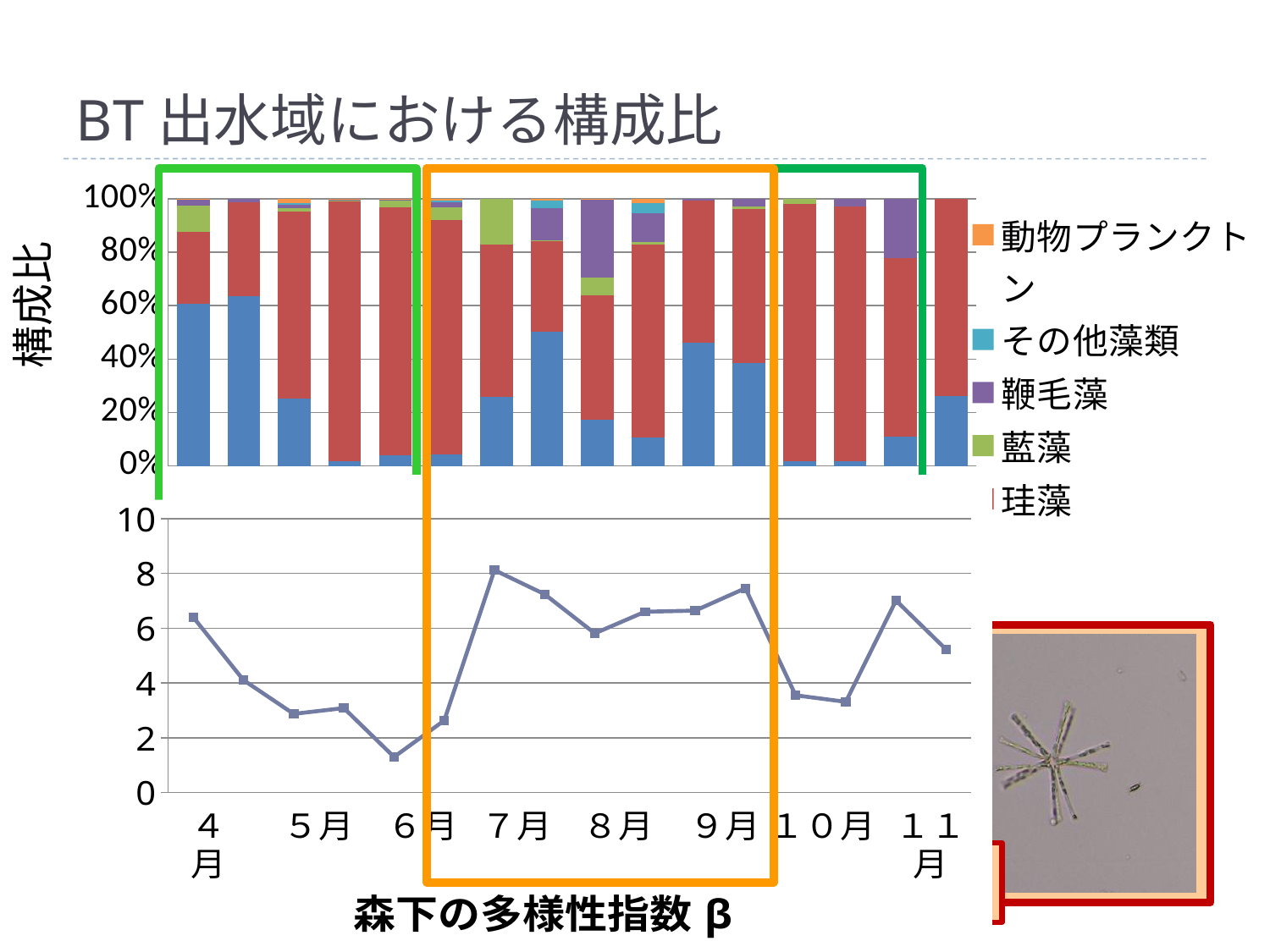
In the top chart, which colour represents 珪藻 in the legend? red On the bottom line chart, do the values rise or fall from 4月 to 6月? fall On the bottom line chart, is the lowest value greater or less than 2? less On the bottom line chart, are the values around 10月 greater or less than 4? less How many bars are plotted in the top stacked bar chart? 16 What is the title of the bottom chart? 森下の多様性指数 β On the bottom line chart, is the highest value greater or less than 7? greater What kind of chart is the top chart on the slide? stacked bar chart What kind of chart is the bottom chart (森下の多様性指数 β)? line chart In the top chart, what is the total of each stacked bar? 100% How many data points are plotted on the bottom line chart? 16 How many series does the legend of the top chart list? 5